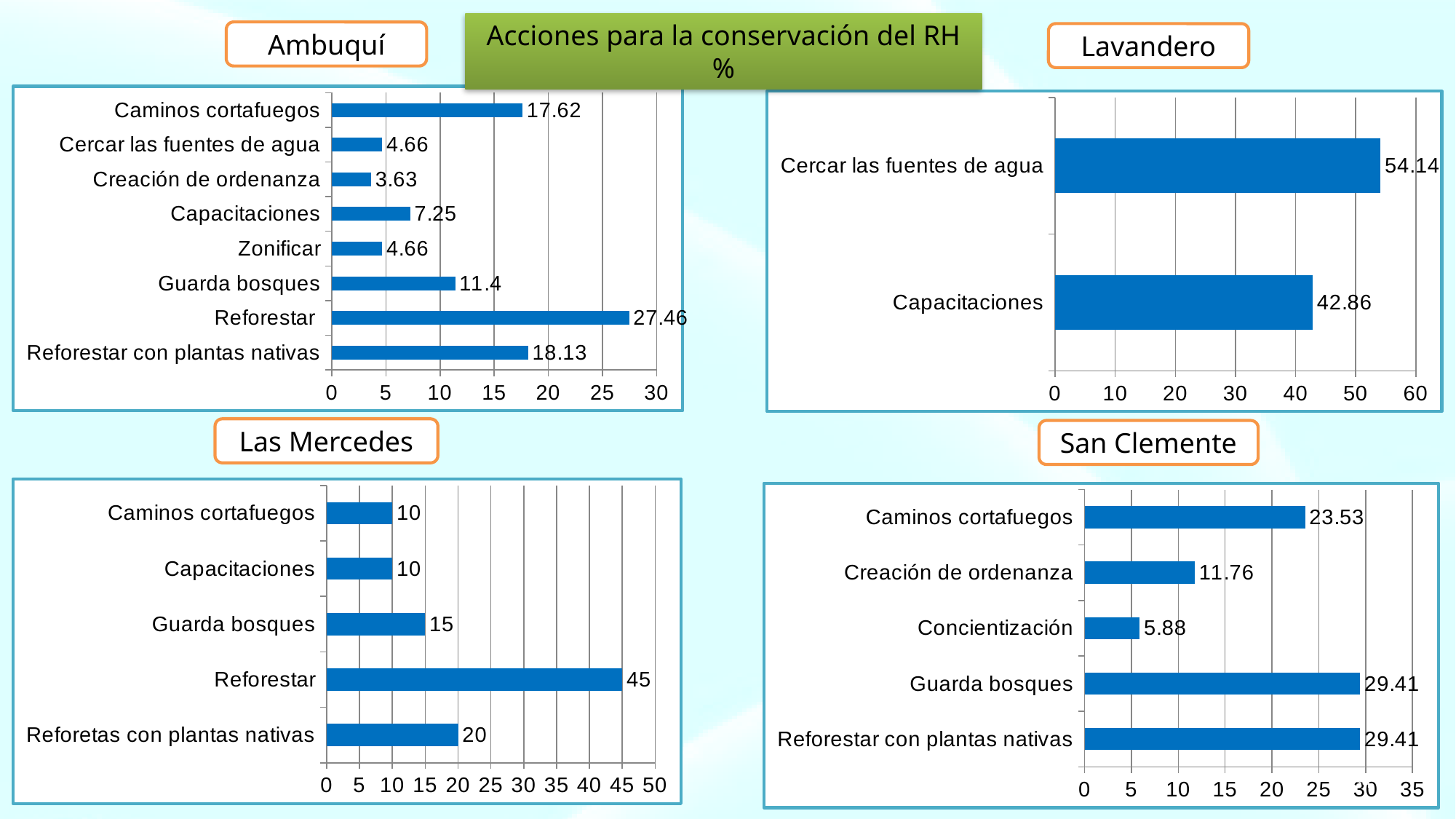
In the Lavandero chart, what is the difference between Cercar las fuentes de agua and Capacitaciones? 11.28 In the Las Mercedes chart, what is the value for Guarda bosques? 15 In the Lavandero chart, what is the value for Cercar las fuentes de agua? 54.14 In the Las Mercedes chart, which category has the highest value? Reforestar In the Ambuquí chart, what is the difference between Reforestar con plantas nativas and Caminos cortafuegos? 0.51 In the San Clemente chart, what is the value for Concientización? 5.88 In the Ambuquí chart, how many categories are shown? 8 In the Lavandero chart, which is larger, Cercar las fuentes de agua or Capacitaciones? Cercar las fuentes de agua In the San Clemente chart, how many categories are shown? 5 What type of chart is the Las Mercedes chart? Bar chart In the Ambuquí chart, what is the value for Reforestar? 27.46 In the Ambuquí chart, which category has the lowest value? Creación de ordenanza